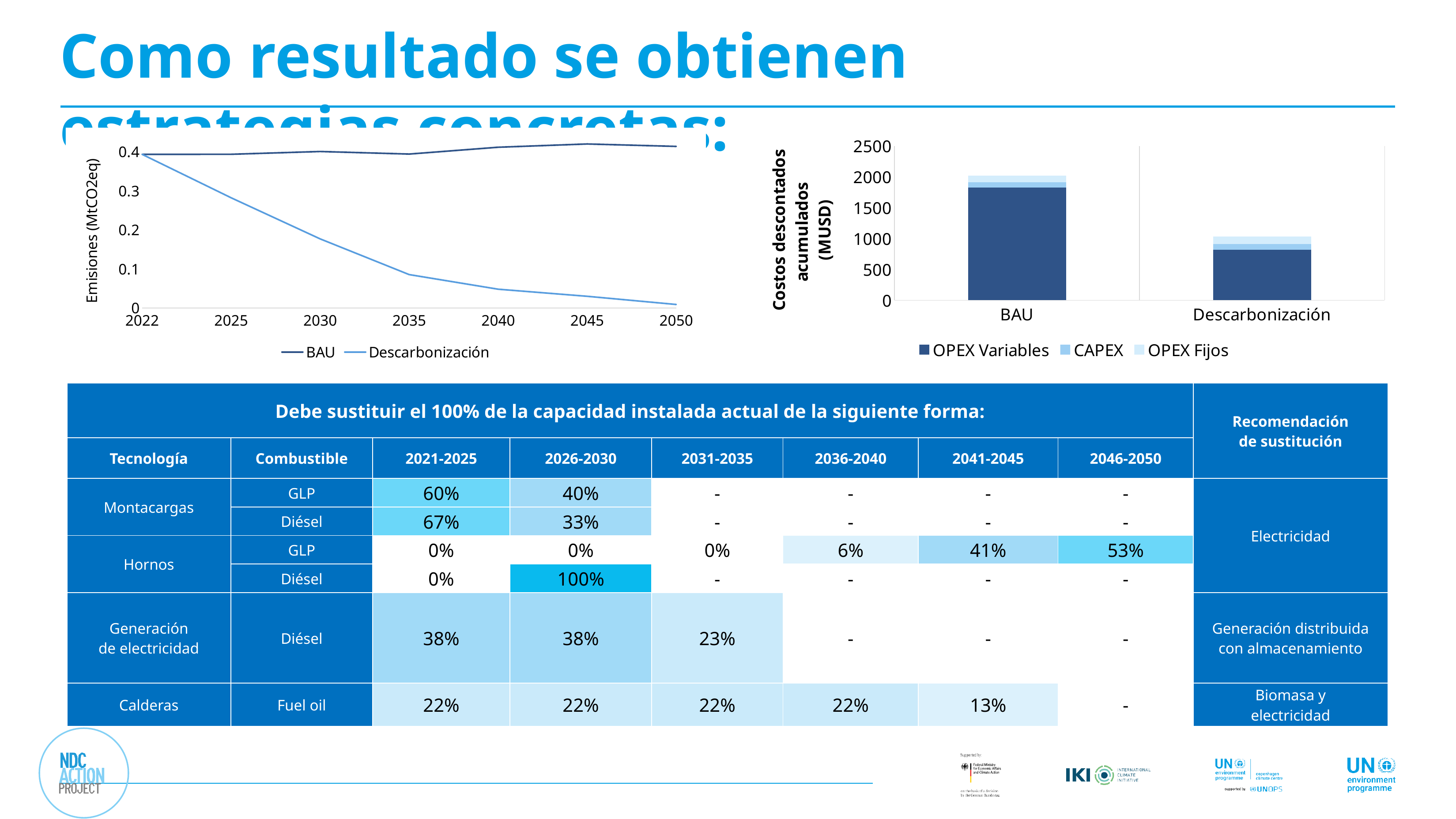
In the costs bar chart on the right, how many categories are shown on the x axis? 2 What is the y-axis label of the emissions line chart on the left? Emisiones (MtCO2eq) In the costs bar chart on the right, how many series does the legend list? 3 In the emissions line chart on the left, which series is higher in 2040, BAU or Descarbonización? BAU In the emissions line chart on the left, how many series does the legend list? 2 In the emissions line chart on the left, does the Descarbonización series rise or fall from 2022 to 2050? fall In the emissions line chart on the left, is the Descarbonización value in 2050 greater or less than 0.1? less What kind of chart is the chart on the left of the slide showing emissions? line chart What kind of chart is the chart on the right of the slide showing costs? bar chart In the costs bar chart on the right, is the total for Descarbonización greater or less than 1500? less In the costs bar chart on the right, is the total for BAU greater or less than 1500? greater In the costs bar chart on the right, which category has the taller stacked bar, BAU or Descarbonización? BAU